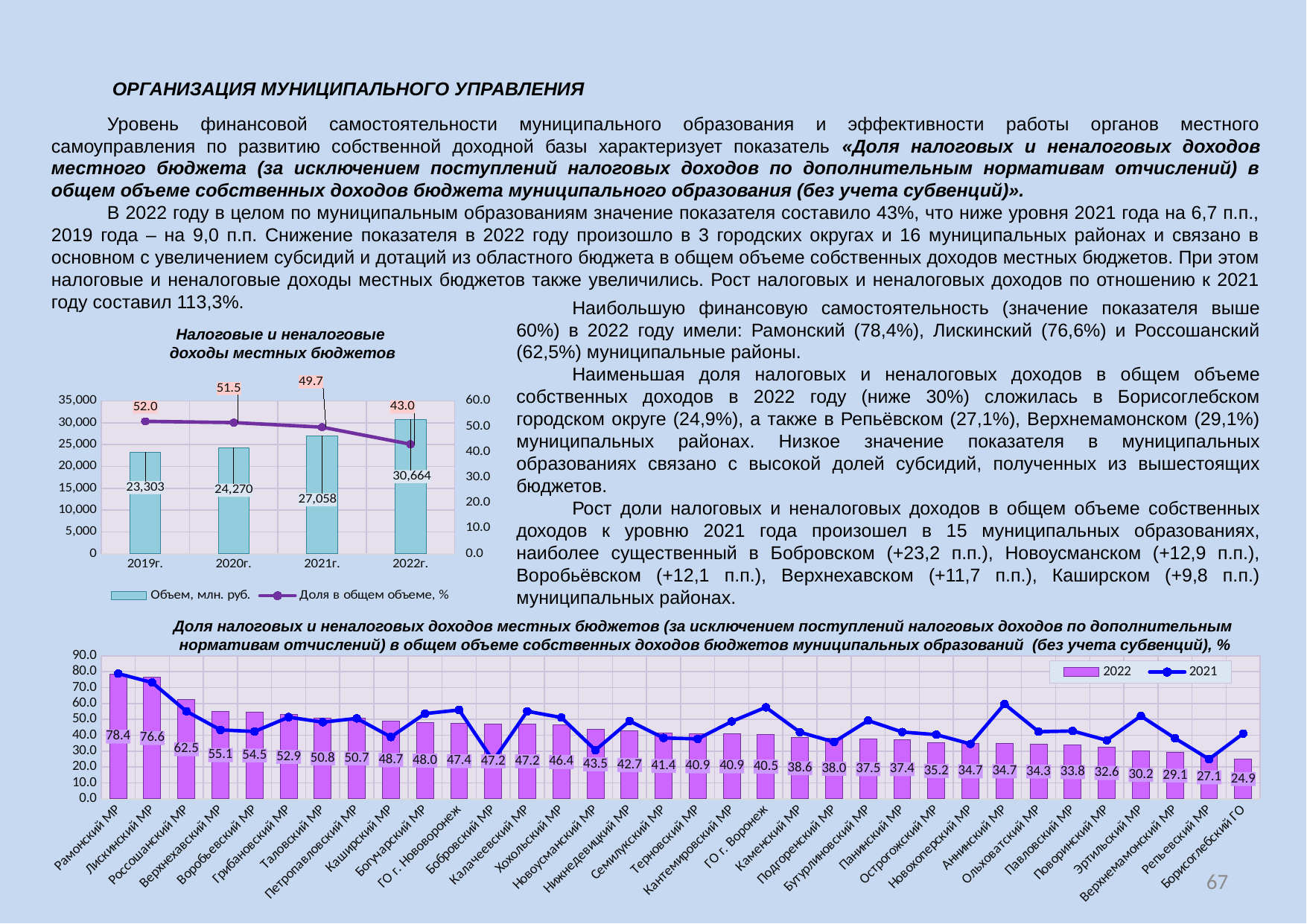
In the bottom chart 'Доля налоговых и неналоговых доходов местных бюджетов...', how many municipalities are shown on the x axis? 34 In the bottom chart 'Доля налоговых и неналоговых доходов местных бюджетов...', which has a larger 2022 value: Каширский МР or Эртильский МР? Каширский МР In the chart 'Налоговые и неналоговые доходы местных бюджетов', what is the value of 'Объем, млн. руб.' for 2022г.? 30,664 In the chart 'Налоговые и неналоговые доходы местных бюджетов', how many series does the legend list? 2 In the bottom chart 'Доля налоговых и неналоговых доходов местных бюджетов...', is the 2021 value for Рамонский МР greater or less than 70.0? greater In the bottom chart 'Доля налоговых и неналоговых доходов местных бюджетов...', what is the 2022 value for ГО г. Воронеж? 40.5 In the bottom chart 'Доля налоговых и неналоговых доходов местных бюджетов...', which municipality has the highest 2022 value? Рамонский МР In the chart 'Налоговые и неналоговые доходы местных бюджетов', by how much did 'Объем, млн. руб.' increase from 2021г. to 2022г.? 3,606 In the bottom chart 'Доля налоговых и неналоговых доходов местных бюджетов...', what is the difference between the 2022 values for Рамонский МР and Лискинский МР? 1.8 In the bottom chart 'Доля налоговых и неналоговых доходов местных бюджетов...', which municipality has the lowest 2022 value? Борисоглебский ГО In the chart 'Налоговые и неналоговые доходы местных бюджетов', what is the value of 'Доля в общем объеме, %' for 2019г.? 52.0 In the chart 'Налоговые и неналоговые доходы местных бюджетов', does the 'Доля в общем объеме, %' line rise or fall from 2019г. to 2022г.? fall